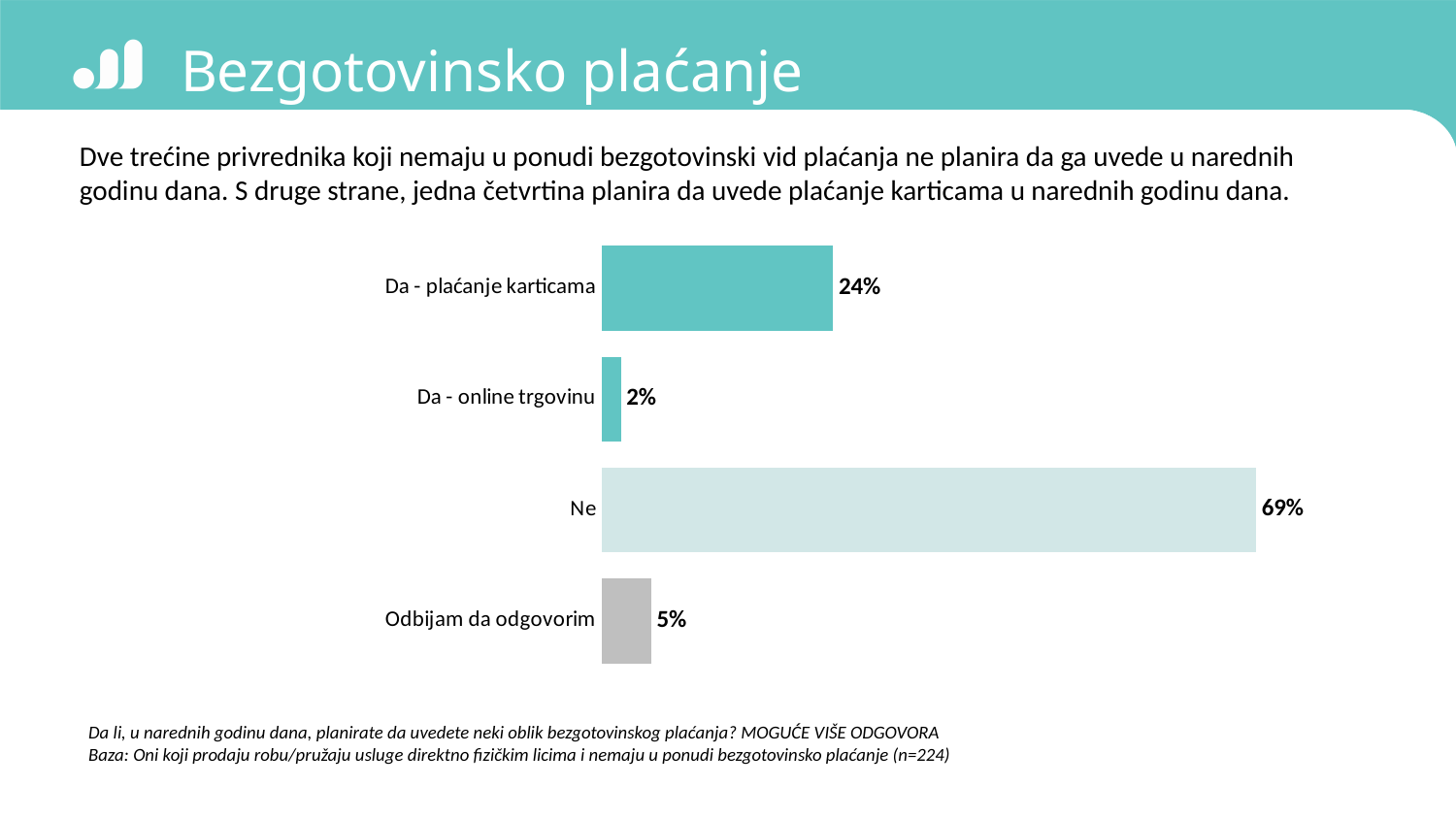
What kind of chart is shown on the slide? Bar chart What is the difference between the values for "Odbijam da odgovorim" and "Da - online trgovinu"? 3% Which is larger, the value for "Da - plaćanje karticama" or the value for "Odbijam da odgovorim"? Da - plaćanje karticama What is the value for "Odbijam da odgovorim"? 5% What is the title of the slide? Bezgotovinsko plaćanje Which category has the lowest value? Da - online trgovinu What is the difference between the values for "Ne" and "Da - plaćanje karticama"? 45% What is the value for "Da - plaćanje karticama"? 24% What is the value for "Ne"? 69% How many categories are shown in the chart? 4 What is the value for "Da - online trgovinu"? 2% Which category has the highest value? Ne